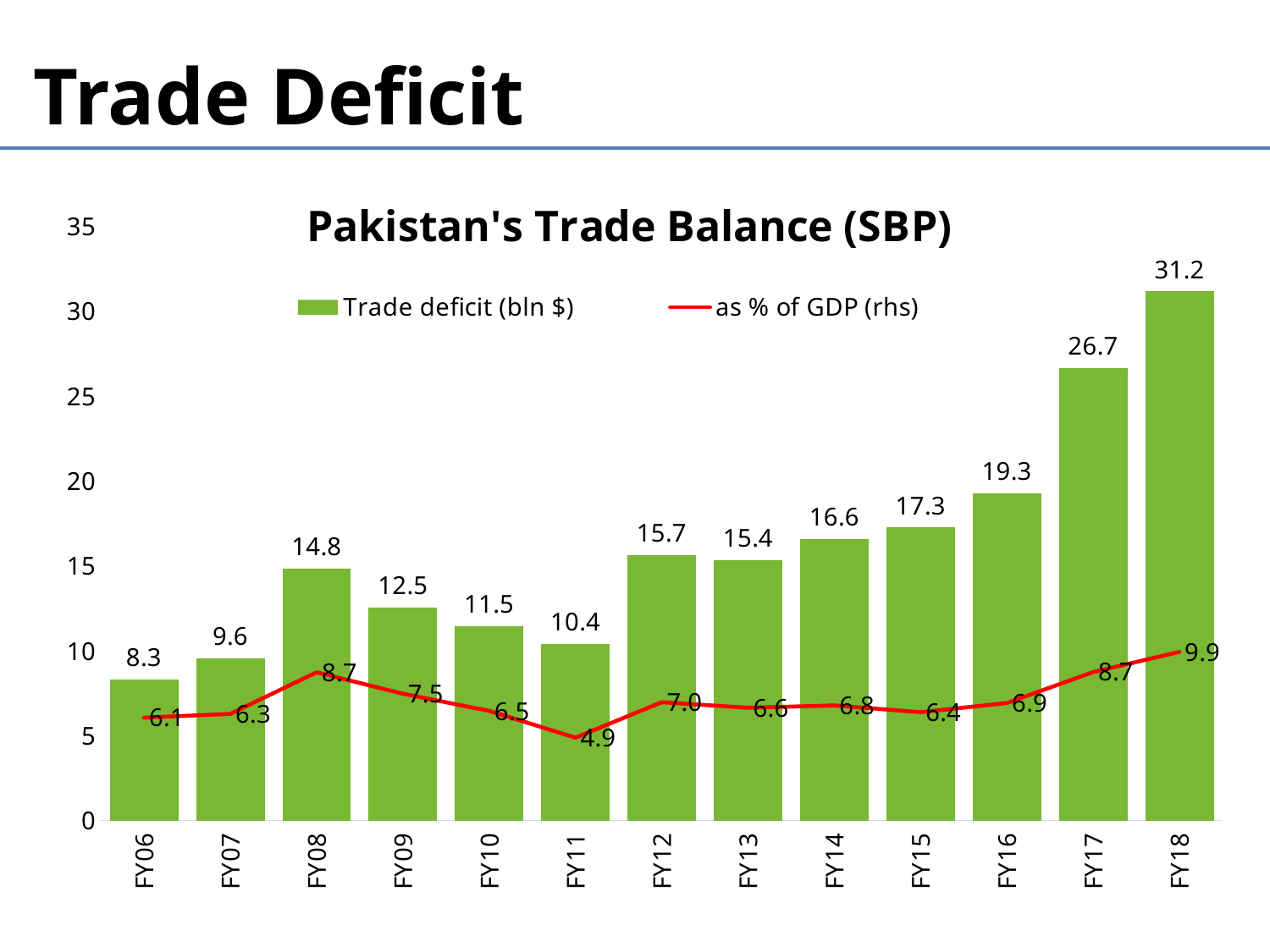
What is the trade deficit as % of GDP for FY11? 4.9 What is the title of the chart? Pakistan's Trade Balance (SBP) How many fiscal years are shown on the x axis? 13 Which fiscal year has the highest trade deficit (bln $)? FY18 What kind of chart is used for the trade deficit (bln $) series? bar chart What is the trade deficit (bln $) for FY18? 31.2 Does the trade deficit (bln $) rise or fall from FY15 to FY18? rise What is the difference in trade deficit (bln $) between FY18 and FY17? 4.5 Which fiscal year has the lowest trade deficit as % of GDP? FY11 What is the trade deficit (bln $) for FY08? 14.8 How many series does the legend list? 2 Which is larger, the trade deficit (bln $) in FY12 or in FY13? FY12